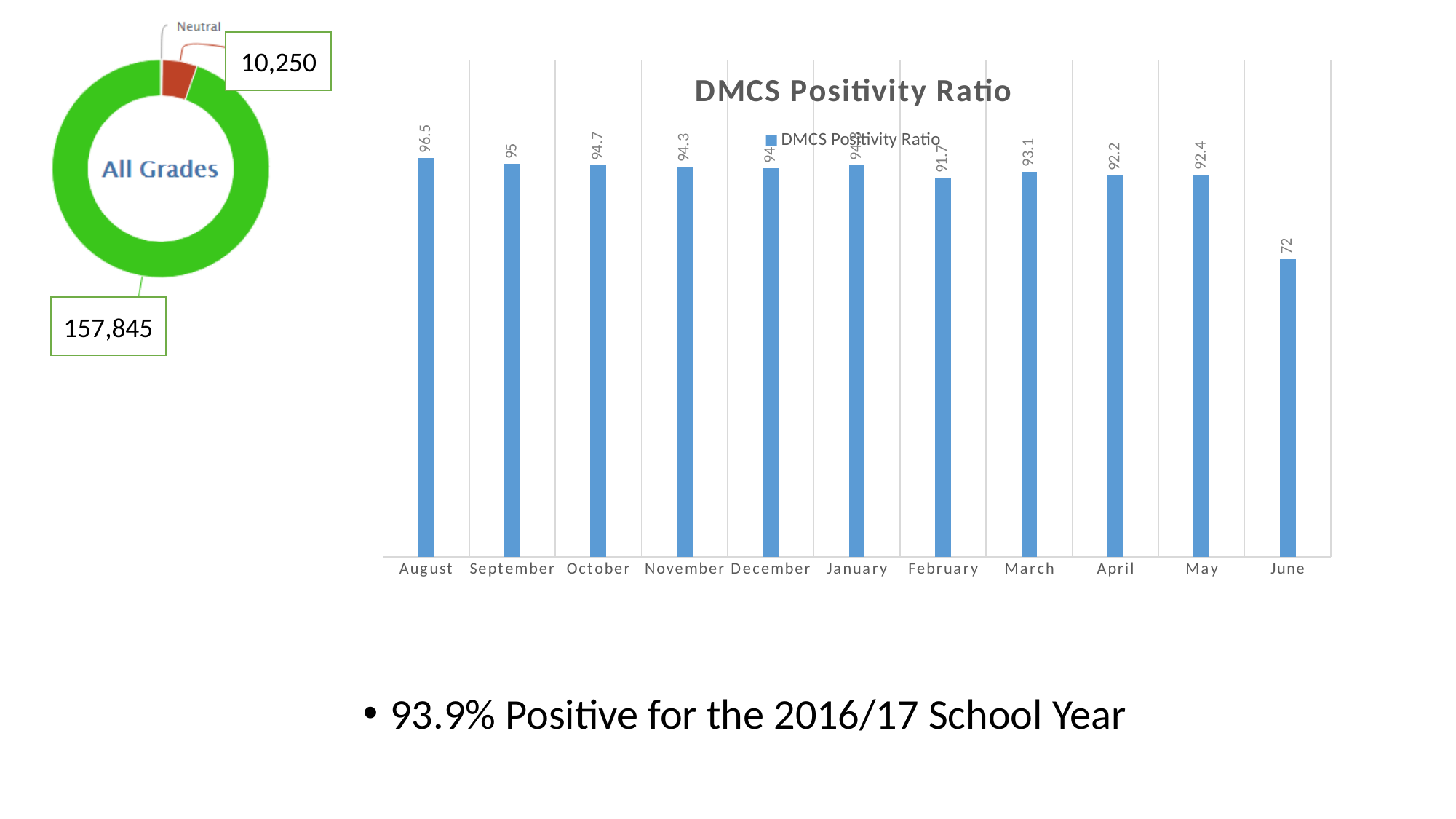
In the DMCS Positivity Ratio chart, which is larger, the value for March or the value for April? March How many months are shown on the x axis of the DMCS Positivity Ratio chart? 11 In the DMCS Positivity Ratio chart, what is the value for February? 91.7 In the DMCS Positivity Ratio chart, which month has the lowest value? June What kind of chart is the DMCS Positivity Ratio chart? Bar chart How many series does the legend of the DMCS Positivity Ratio chart list? 1 In the DMCS Positivity Ratio chart, which month has the highest value? August In the DMCS Positivity Ratio chart, what is the value for June? 72 In the DMCS Positivity Ratio chart, what is the difference between the March and February values? 1.4 In the DMCS Positivity Ratio chart, what is the difference between the August and June values? 24.5 In the All Grades doughnut chart on the left, what value is shown for the Neutral segment? 10,250 In the DMCS Positivity Ratio chart, what is the value for August? 96.5